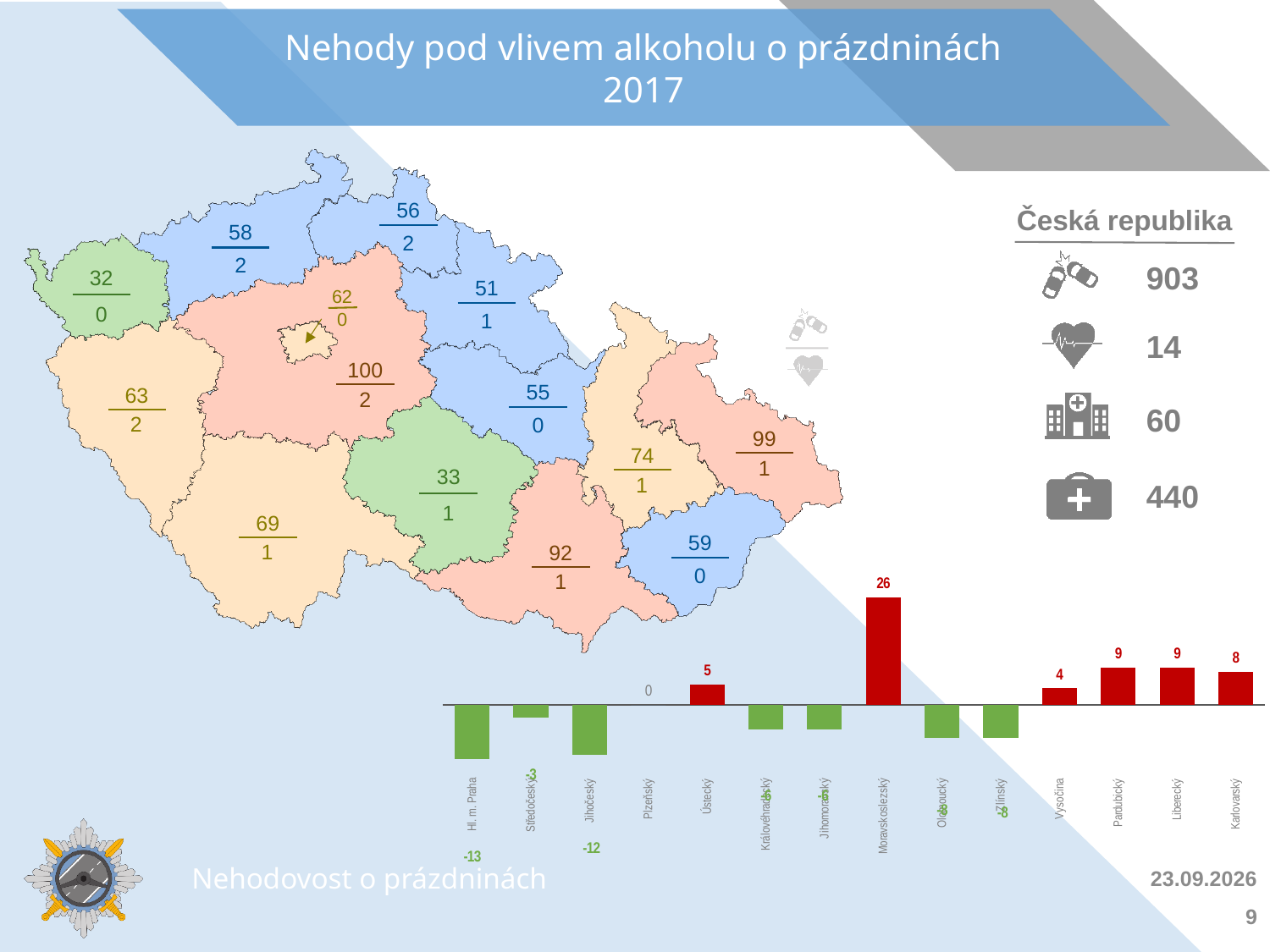
How many regions are shown on the x axis of the bar chart? 14 In the bar chart, what is the value for Plzeňský? 0 What kind of chart is shown at the bottom of the slide? bar chart In the bar chart, which is larger: the value for Moravskoslezský or the value for Karlovarský? Moravskoslezský In the bar chart, what is the value for Moravskoslezský? 26 In the bar chart, what is the value for Jihočeský? -12 In the bar chart, what is the difference between the values for Moravskoslezský and Ústecký? 21 Which region has the lowest value in the bar chart? Hl. m. Praha In the bar chart, what is the value for Hl. m. Praha? -13 In the bar chart, what is the value for Karlovarský? 8 In the bar chart, what is the value for Ústecký? 5 Which region has the highest value in the bar chart? Moravskoslezský